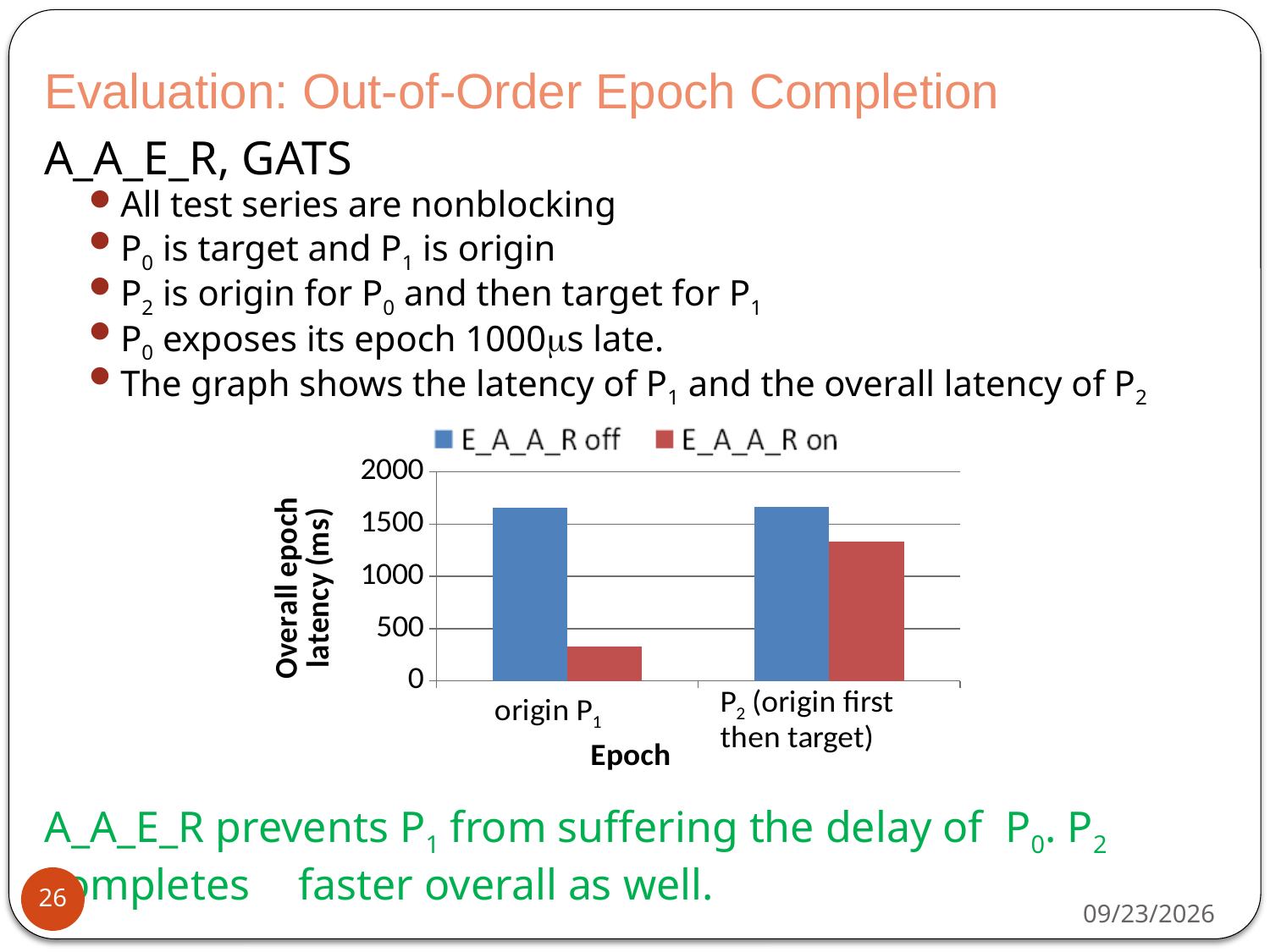
For P2 (origin first then target), which is larger: the E_A_A_R off value or the E_A_A_R on value? E_A_A_R off For origin P1, which is larger: the E_A_A_R off value or the E_A_A_R on value? E_A_A_R off Is the E_A_A_R on value for P2 (origin first then target) greater or less than 1000? greater What kind of chart is shown on the slide? bar chart Is the E_A_A_R off value for origin P1 greater or less than 1500? greater How many series does the chart's legend list? 2 How many categories are shown on the x axis of the chart? 2 Is the E_A_A_R on value for P2 (origin first then target) greater or less than 1500? less Within the E_A_A_R on series, which category has the higher value? P2 (origin first then target) What is the label of the chart's vertical axis? Overall epoch latency (ms) Which bar in the chart is the lowest? E_A_A_R on for origin P1